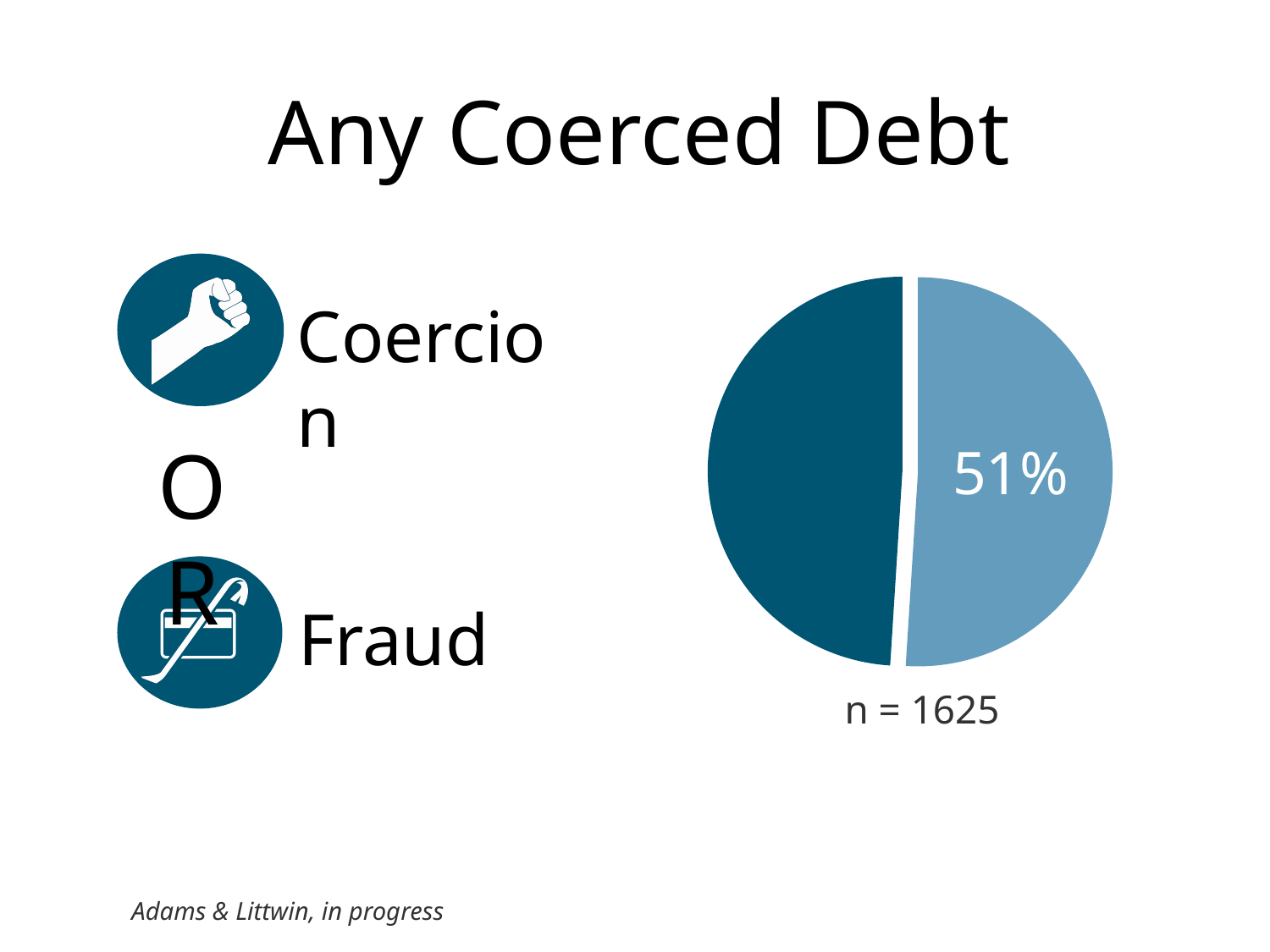
What sample size (n) is shown below the pie chart? n = 1625 How many slices does the pie chart have? 2 What is the title of the slide containing the pie chart? Any Coerced Debt Is the share of the light blue slice greater or less than 50%? greater What kind of chart is shown on the slide? pie chart Which slice of the pie chart is larger, the light blue slice or the dark blue slice? the light blue slice What percentage is printed on the light blue slice of the pie chart? 51%